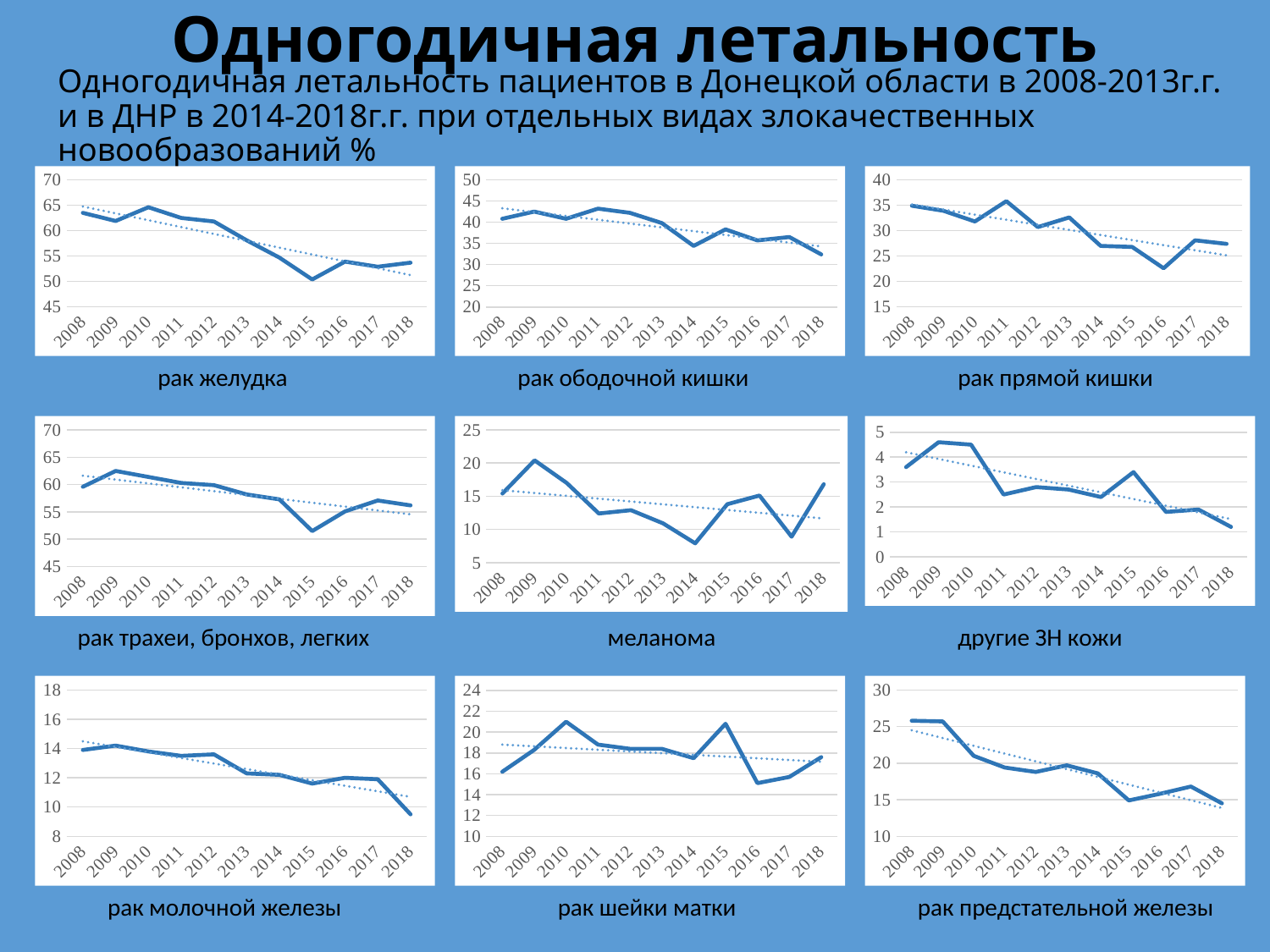
In the 'меланома' chart, which year has the highest value? 2009 How many charts are shown on the slide? 9 In the 'рак желудка' chart, do the values generally rise or fall from 2008 to 2018? fall In the 'рак предстательной железы' chart, is the value for 2010 greater or less than 20? greater In the 'рак прямой кишки' chart, which year has the larger value, 2011 or 2016? 2011 How many years are plotted along the x axis of the 'рак желудка' chart? 11 In the 'рак молочной железы' chart, is the value for 2018 greater or less than 10? less In the 'другие ЗН кожи' chart, which year has the lowest value? 2018 In the 'рак желудка' chart, is the value for 2015 greater or less than 55? less In the 'меланома' chart, which year has the lowest value? 2014 What kind of chart is the 'рак желудка' chart? line chart